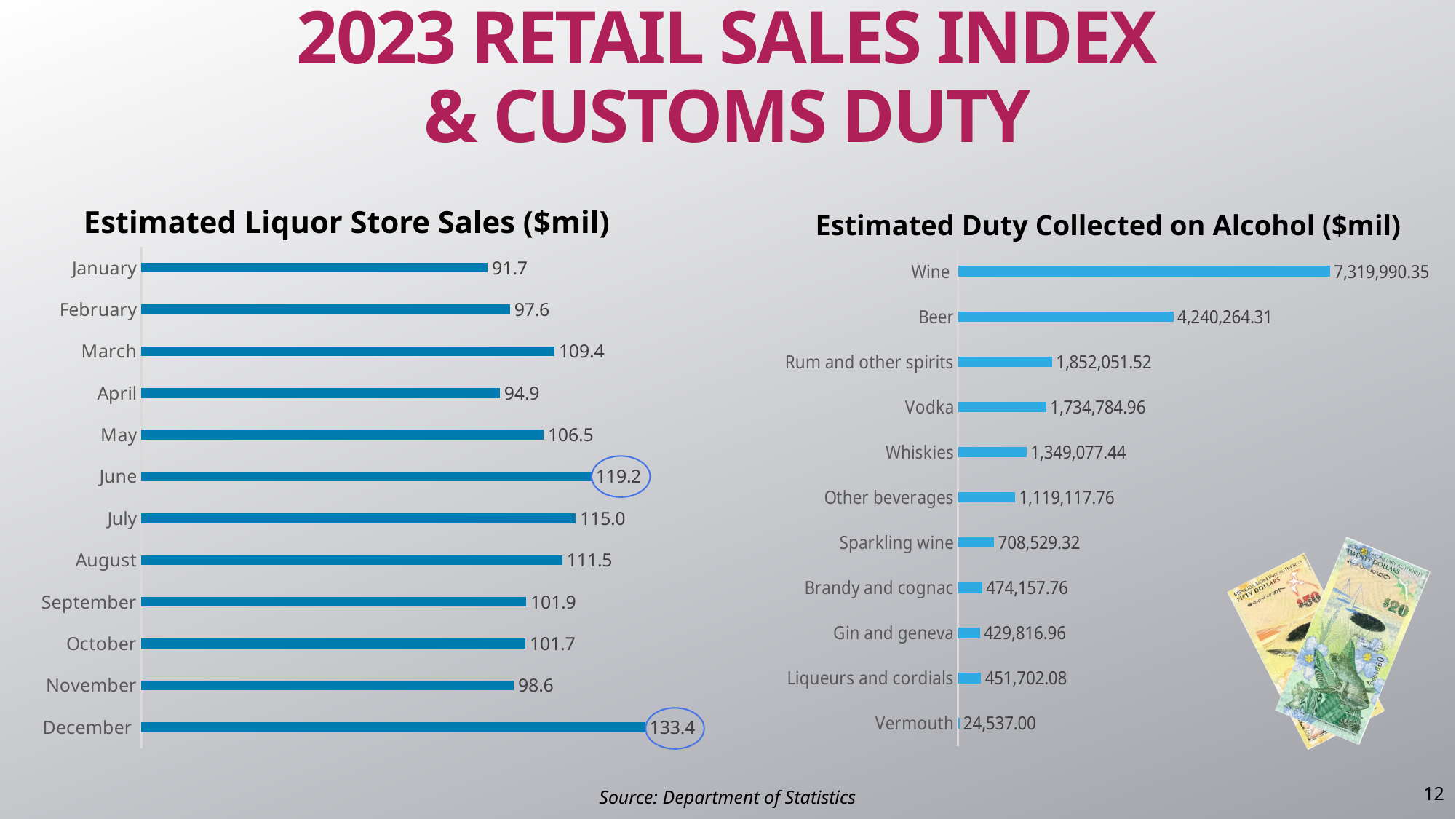
In the 'Estimated Duty Collected on Alcohol ($mil)' chart, what is the value for Beer? 4,240,264.31 In the 'Estimated Duty Collected on Alcohol ($mil)' chart, which category has the lowest value? Vermouth In the 'Estimated Liquor Store Sales ($mil)' chart, which month has the highest value? December How many months are shown in the 'Estimated Liquor Store Sales ($mil)' chart? 12 In the 'Estimated Duty Collected on Alcohol ($mil)' chart, which is larger, Brandy and cognac or Liqueurs and cordials? Brandy and cognac In the 'Estimated Liquor Store Sales ($mil)' chart, which month has the lowest value? January In the 'Estimated Liquor Store Sales ($mil)' chart, which is larger, March or May? March What kind of chart is the 'Estimated Liquor Store Sales ($mil)' chart? Bar chart In the 'Estimated Liquor Store Sales ($mil)' chart, what is the difference between December and January? 41.7 How many categories are shown in the 'Estimated Duty Collected on Alcohol ($mil)' chart? 11 In the 'Estimated Liquor Store Sales ($mil)' chart, what is the value for June? 119.2 In the 'Estimated Duty Collected on Alcohol ($mil)' chart, which category has the highest value? Wine